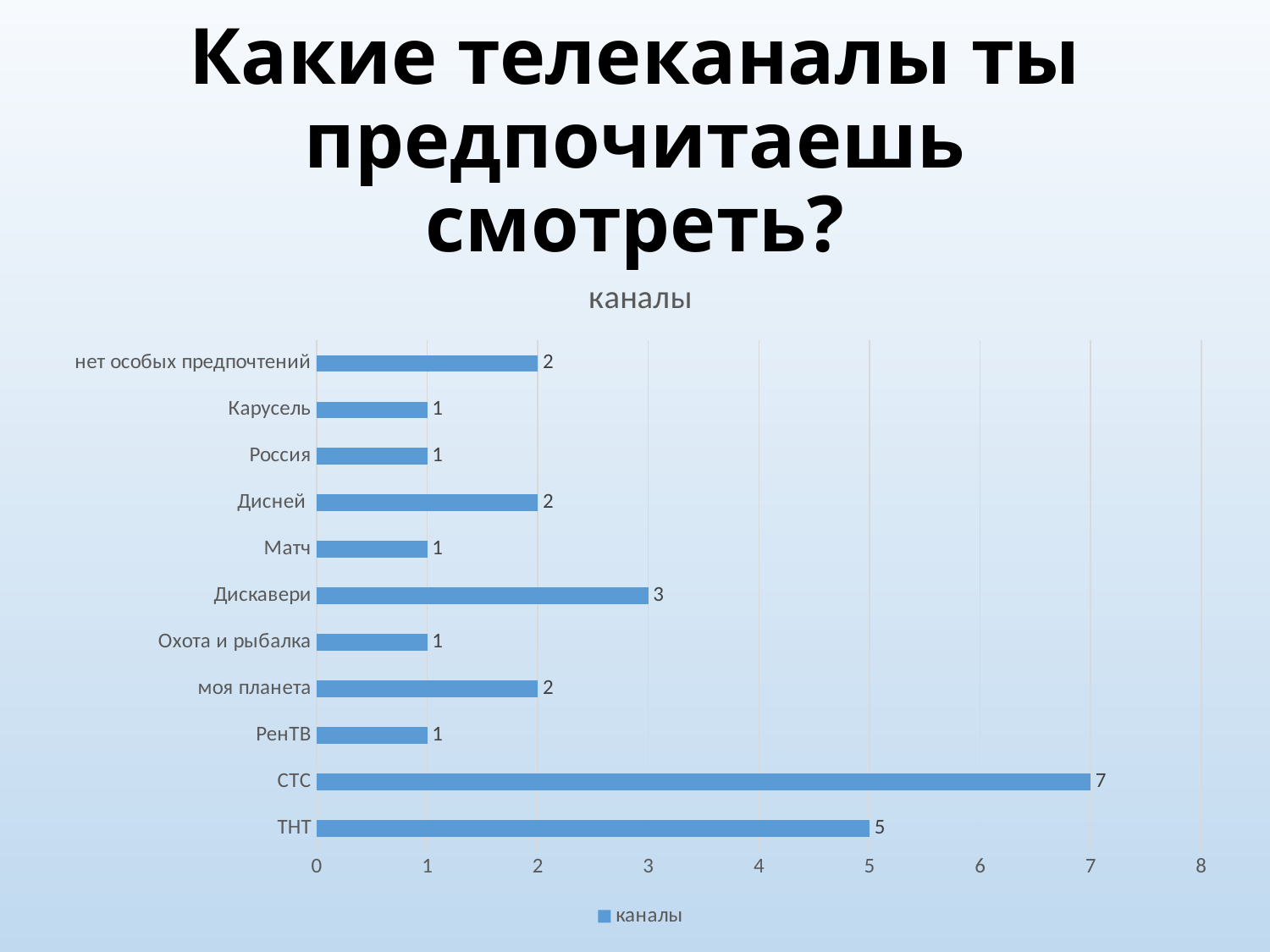
What is the difference between the values for ТНТ and Дискавери? 2 How many series does the legend list? 1 What is the value for нет особых предпочтений? 2 Which is larger, the value for Дискавери or the value for Дисней? Дискавери What is the title of the chart? каналы What kind of chart is shown on the slide? bar chart What is the value for СТС? 7 What is the difference between the values for СТС and ТНТ? 2 What is the value for Дискавери? 3 How many categories are shown in the chart? 11 Which category has the highest value? СТС What is the value for ТНТ? 5